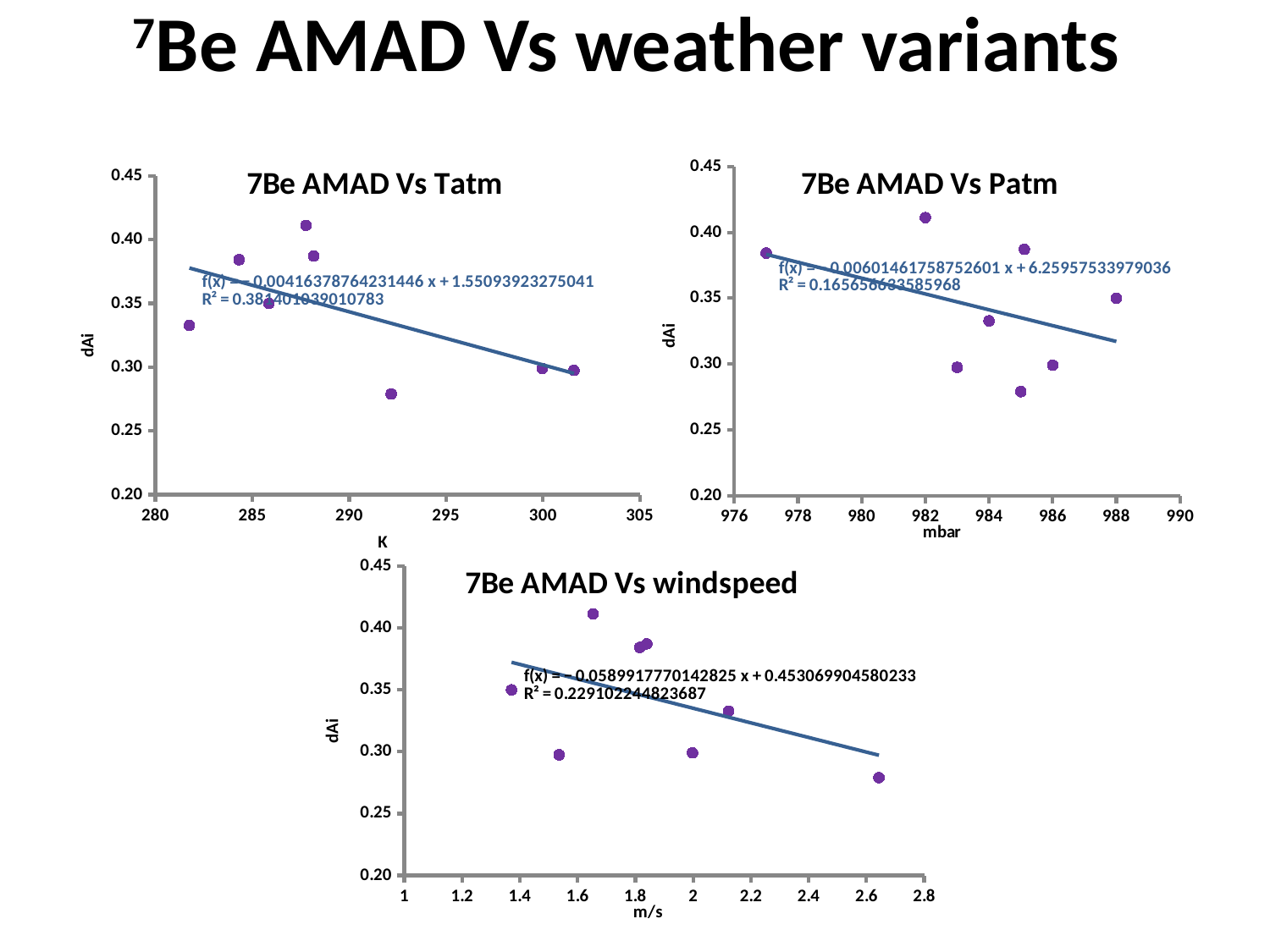
What unit is shown on the x axis of the "7Be AMAD Vs Patm" chart? mbar What kind of chart is "7Be AMAD Vs Tatm"? scatter chart In the "7Be AMAD Vs windspeed" chart, which has the higher dAi value: the point near 1.65 m/s or the point near 2.64 m/s? the point near 1.65 m/s In the "7Be AMAD Vs Patm" chart, is the dAi value of the highest point (near 982 mbar) greater or less than 0.40? greater In the "7Be AMAD Vs Tatm" chart, which has the lower dAi value: the point near 292 K or the point near 288 K? the point near 292 K How many data points are plotted in the "7Be AMAD Vs windspeed" chart? 8 In the "7Be AMAD Vs windspeed" chart, does the fitted trendline rise or fall as windspeed increases? fall In the "7Be AMAD Vs windspeed" chart, is the dAi value of the point near 2.64 m/s greater or less than 0.30? less How many data points are plotted in the "7Be AMAD Vs Patm" chart? 8 What is the R² value shown on the "7Be AMAD Vs windspeed" chart? 0.229102244823687 In the "7Be AMAD Vs Tatm" chart, does the fitted trendline rise or fall as temperature increases along the x axis? fall In the "7Be AMAD Vs Tatm" chart, is the dAi value of the point near 282 K greater or less than 0.35? less